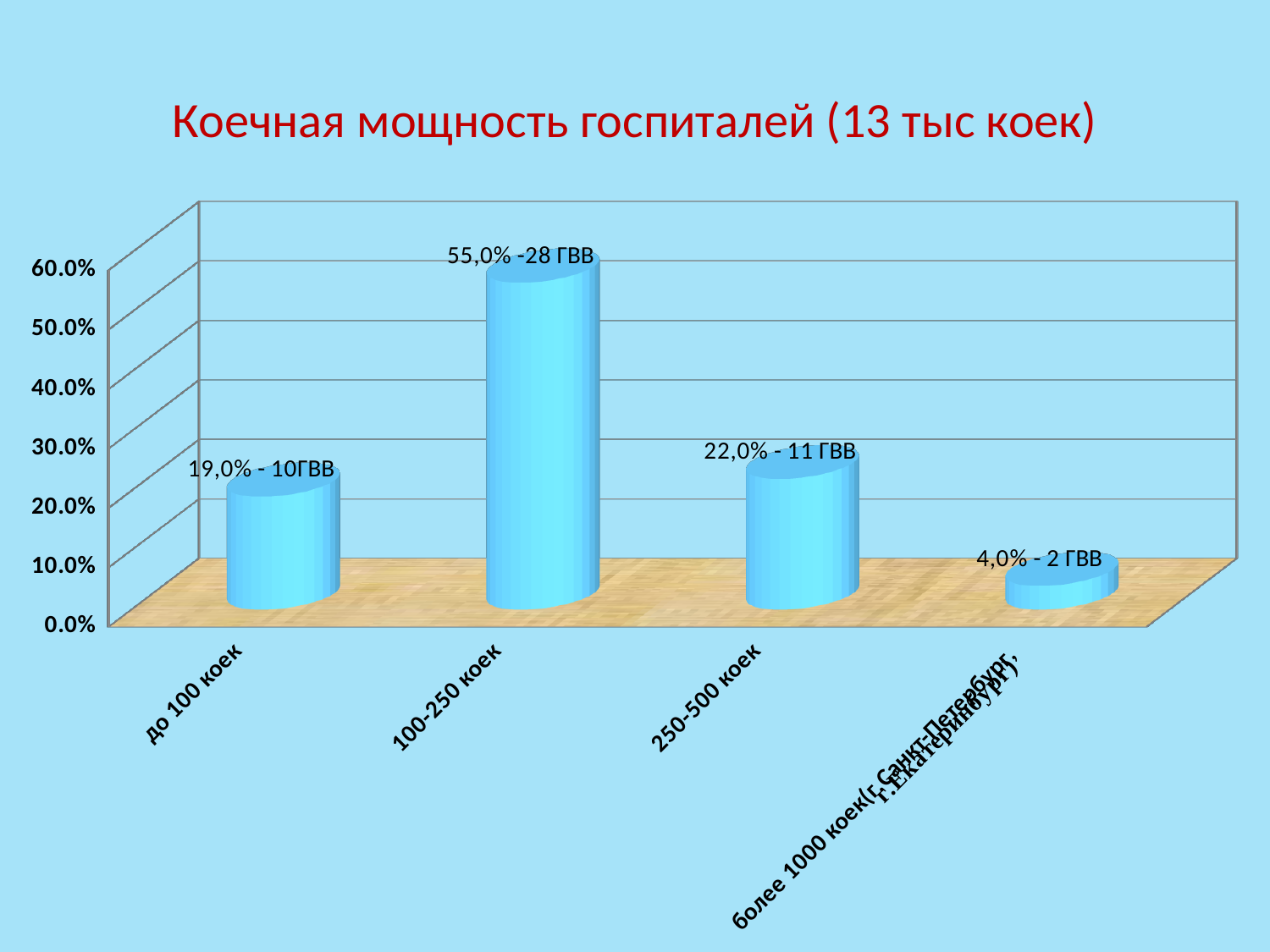
What type of chart is shown on the slide? bar chart What percentage is shown for the category '250-500 коек'? 22,0% How many ГВВ are indicated for the category 'более 1000 коек'? 2 ГВВ Which is larger: the value for 'до 100 коек' or for '250-500 коек'? 250-500 коек Which category has the highest value? 100-250 коек Which category has the lowest value? более 1000 коек(г.Санкт-Петербург, г.Екатеринбург) What is the data label shown for the category '100-250 коек'? 55,0% -28 ГВВ What percentage is shown for the category 'до 100 коек'? 19,0% What is the difference in percentage points between '100-250 коек' and '250-500 коек'? 33,0% Is the value for '100-250 коек' greater or less than 50.0%? greater What is the title of the chart? Коечная мощность госпиталей (13 тыс коек) How many categories are plotted in the chart? 4